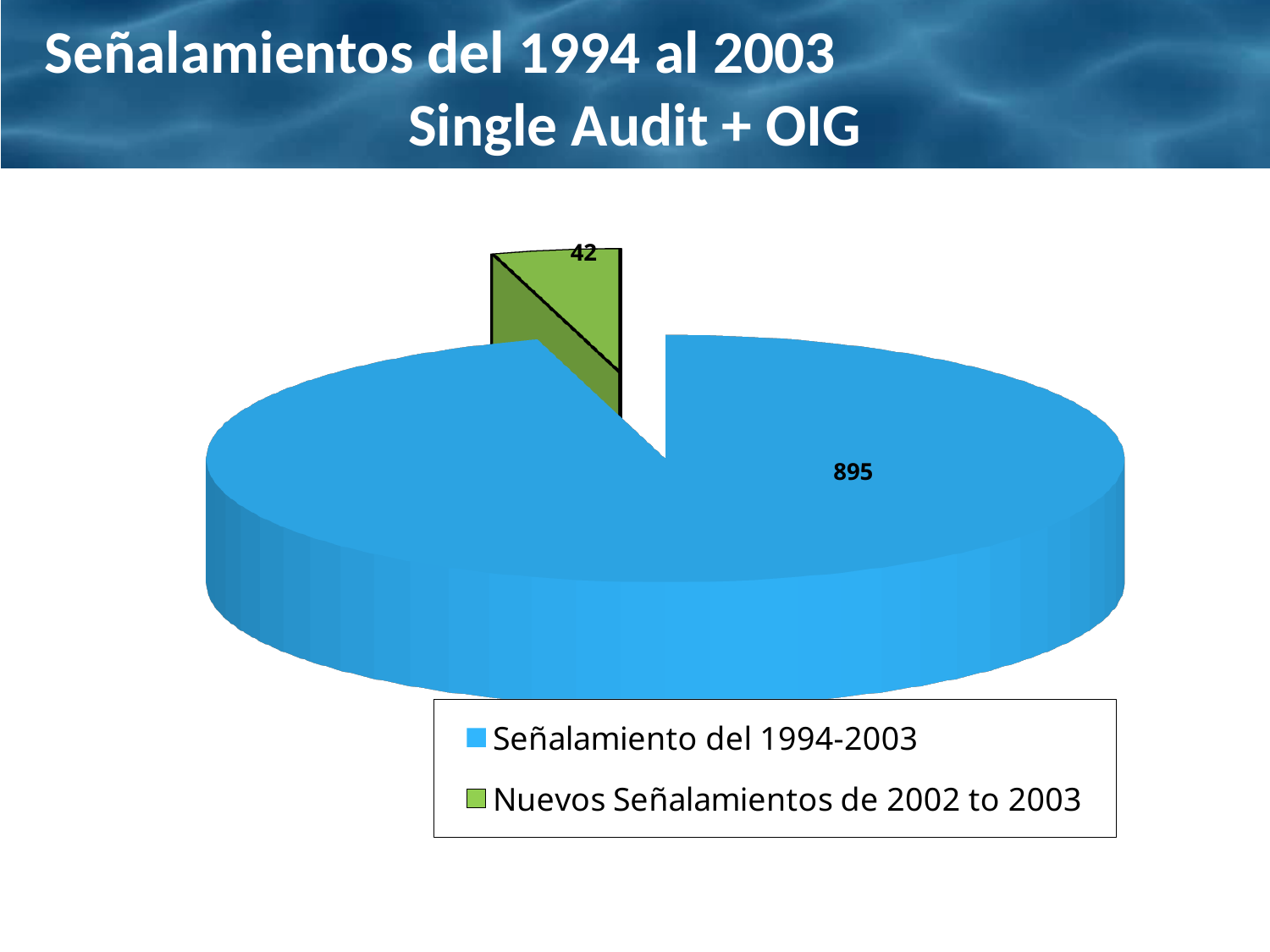
What is the difference between the value for Señalamiento del 1994-2003 and the value for Nuevos Señalamientos de 2002 to 2003? 853 What colour is the slice for Nuevos Señalamientos de 2002 to 2003? green Which category has the smallest slice of the pie? Nuevos Señalamientos de 2002 to 2003 What type of chart is shown on the slide? pie chart What is the value for Nuevos Señalamientos de 2002 to 2003? 42 Which category has the largest slice of the pie? Señalamiento del 1994-2003 How many entries does the legend list? 2 What is the total of the two values shown in the pie chart? 937 Which is larger, the value for Señalamiento del 1994-2003 or the value for Nuevos Señalamientos de 2002 to 2003? Señalamiento del 1994-2003 What is the value for Señalamiento del 1994-2003? 895 How many slices does the pie chart have? 2